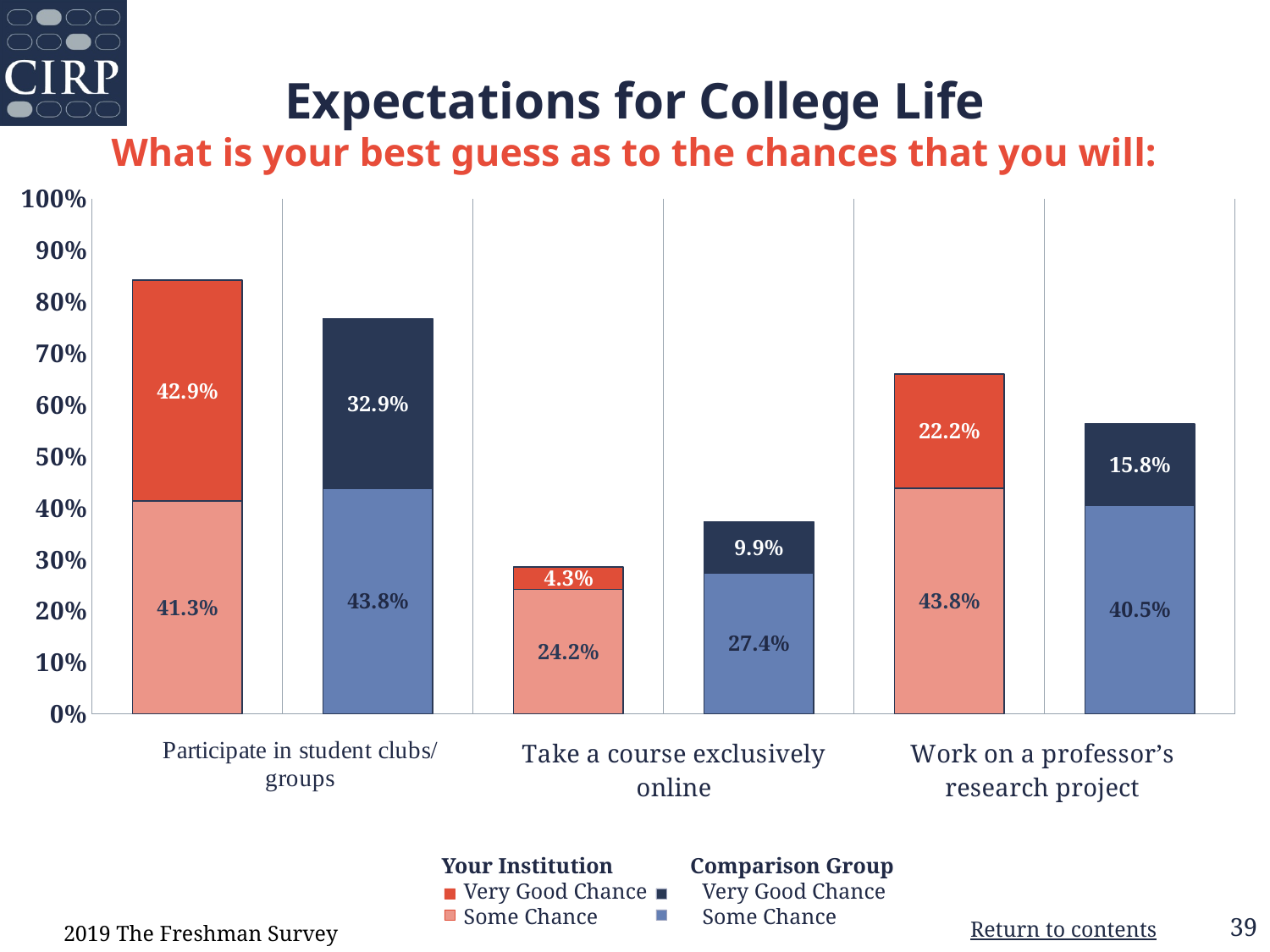
How many categories are shown on the x axis? 3 What is the total of the stacked bar for Your Institution for 'Work on a professor's research project'? 66.0% What is the difference between the 'Very Good Chance' values for Your Institution and the Comparison Group for 'Participate in student clubs/groups'? 10.0% Which category has the highest 'Some Chance' value for the Comparison Group? Participate in student clubs/groups What is the 'Some Chance' value for the Comparison Group for 'Take a course exclusively online'? 27.4% For 'Take a course exclusively online', which is larger: the 'Very Good Chance' value for Your Institution or for the Comparison Group? Comparison Group How many series does the legend list? 4 What is the total of the stacked bar for the Comparison Group for 'Take a course exclusively online'? 37.3% What is the 'Very Good Chance' value for Your Institution for 'Participate in student clubs/groups'? 42.9% Which category has the lowest 'Very Good Chance' value for Your Institution? Take a course exclusively online What kind of chart is shown on the slide? Stacked bar chart What is the 'Very Good Chance' value for the Comparison Group for 'Work on a professor's research project'? 15.8%